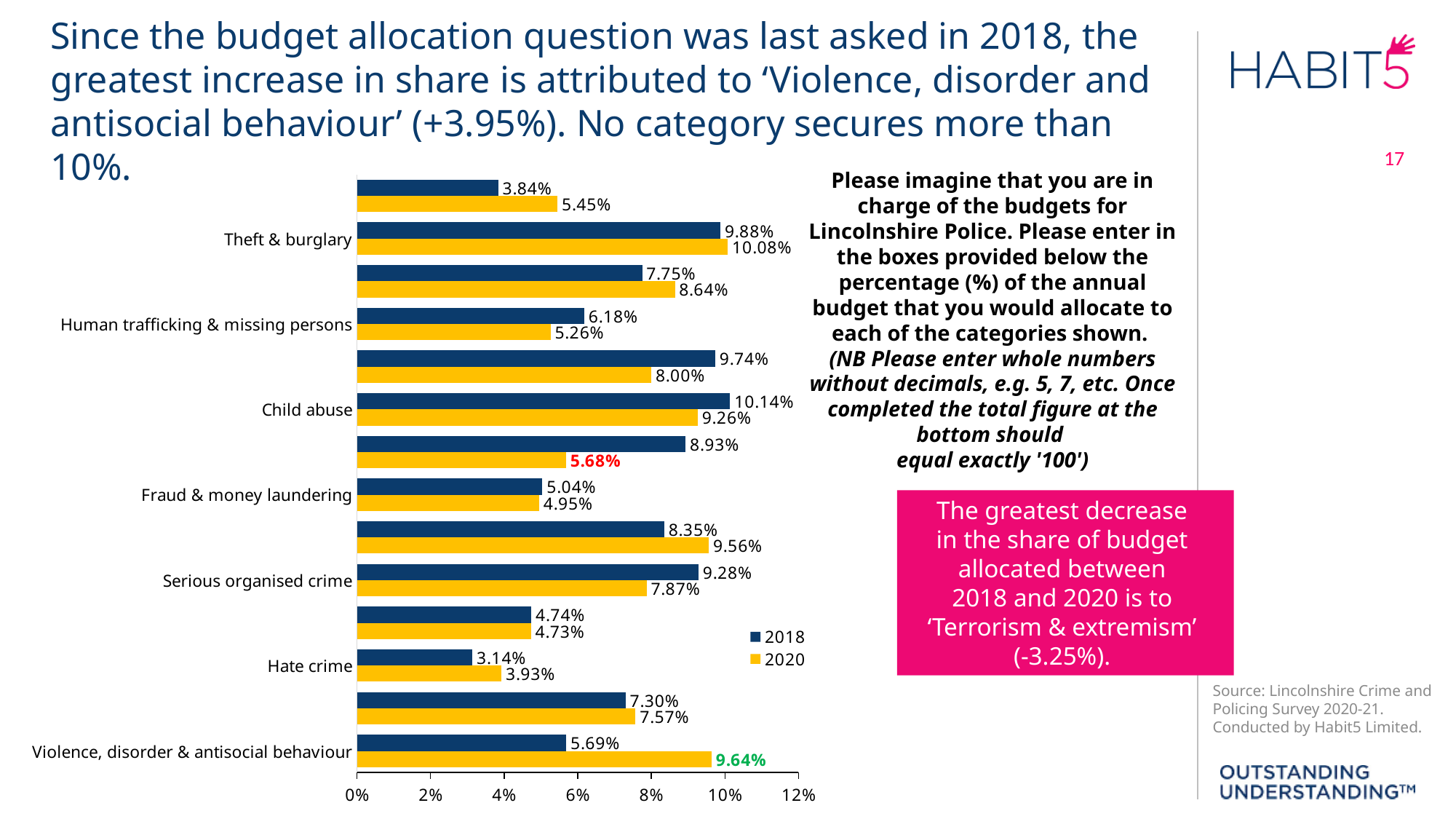
What percentage of the budget was allocated to 'Theft & burglary' in 2020? 10.08% What type of chart is shown on the slide? Bar chart Which labelled category has the highest 2018 value? Child abuse Which category has the highest 2020 value? Theft & burglary What is the difference between the 2018 and 2020 values for 'Serious organised crime'? 1.41% How many series does the legend list? 2 What was the 2018 value for 'Hate crime'? 3.14% For 'Hate crime', which year has the larger value, 2018 or 2020? 2020 What was the 2020 value for 'Violence, disorder & antisocial behaviour'? 9.64% Is the 2020 value for 'Human trafficking & missing persons' greater or less than 6%? less What was the 2018 value for 'Child abuse'? 10.14% By how much did the share for 'Violence, disorder & antisocial behaviour' increase from 2018 to 2020? 3.95%